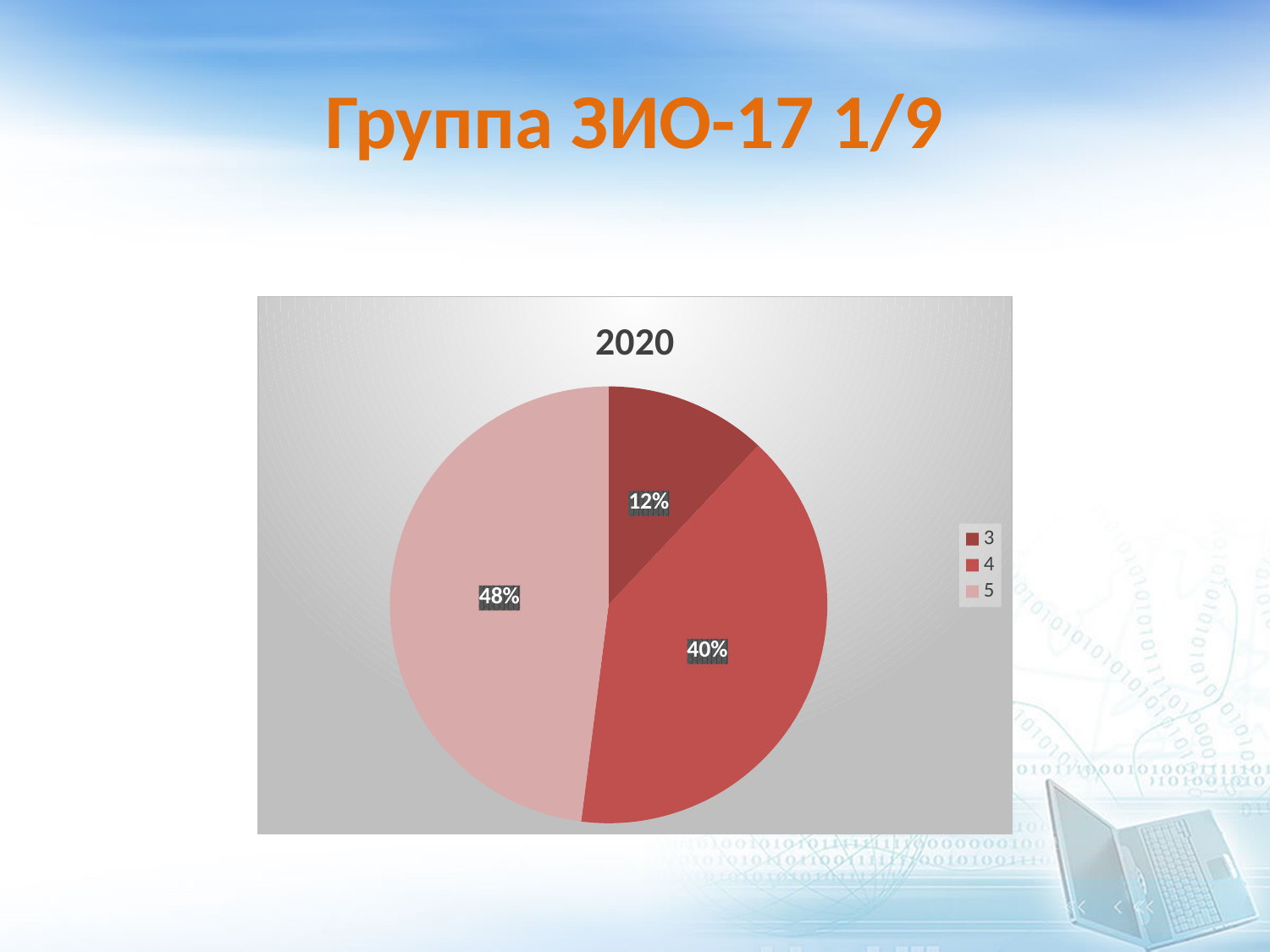
What share of the pie does category 3 have? 12% How many entries does the legend list? 3 Which category has the smallest slice of the pie? 3 What is the combined share of categories 3 and 4? 52% Which slice is larger, category 3 or category 4? 4 What is the difference in percentage points between the slices for category 5 and category 4? 8 Which category has the largest slice of the pie? 5 What share of the pie does category 4 have? 40% What is the title of the chart? 2020 What type of chart is shown on the slide? pie chart How many slices does the pie chart have? 3 What share of the pie does category 5 have? 48%